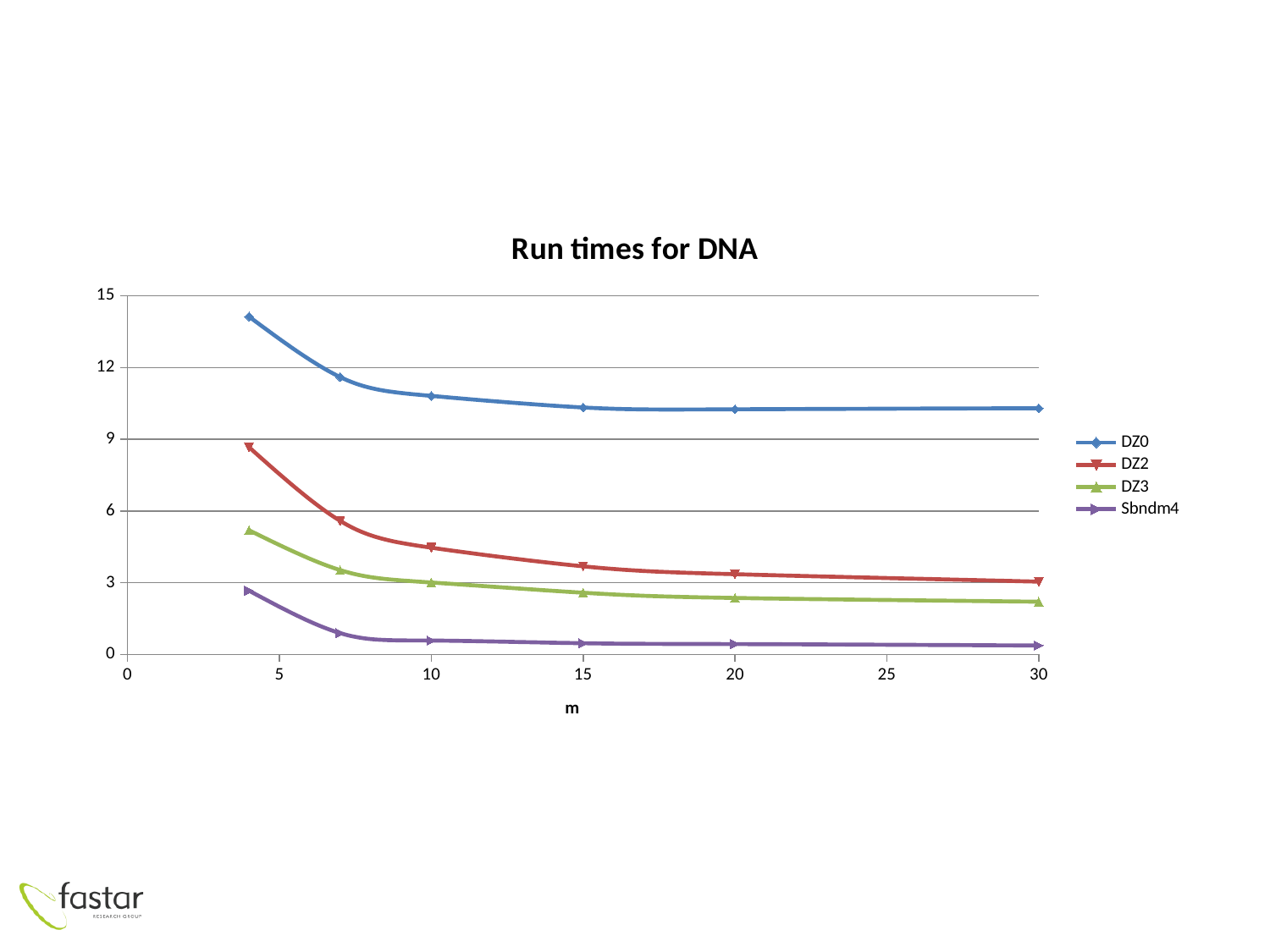
Which is larger at m = 15, the value for DZ2 or the value for DZ3? DZ2 How many series does the legend list? 4 What is the title of the chart? Run times for DNA Is the value for DZ2 at m = 10 greater or less than 3? greater What is the label of the x axis? m What kind of chart is shown on the slide? line chart How many data points are plotted for the DZ0 series? 6 Do the run times for DZ2 rise or fall as m increases? fall Which series has the lowest run time at m = 30? Sbndm4 Is the value for DZ0 at m = 4 greater or less than 12? greater Is the value for DZ3 at m = 30 greater or less than 3? less Which series has the highest run time at m = 10? DZ0